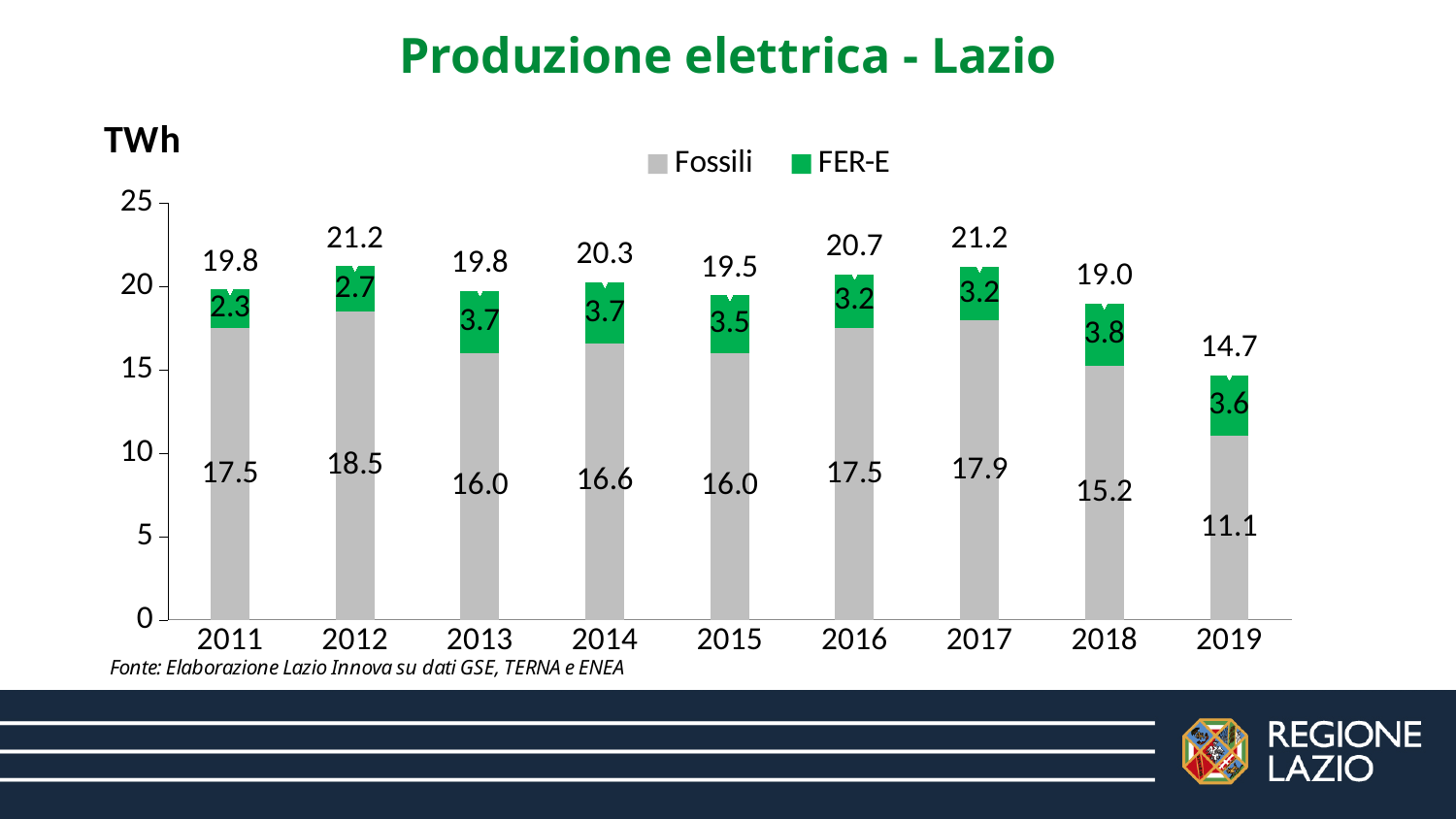
Does the Fossili value rise or fall from 2017 to 2019? Fall What is the FER-E value for 2012? 2.7 Which year has the highest FER-E value? 2018 What kind of chart is shown on the slide? Stacked bar chart What is the total electricity production shown for 2016? 20.7 What is the Fossili value for 2019? 11.1 How many series does the legend list? 2 Which is larger, the FER-E value for 2011 or for 2018? 2018 What is the difference between the Fossili values for 2012 and 2019? 7.4 How many years are shown on the x axis? 9 Which year has the lowest total production? 2019 What unit is indicated for the values on the chart? TWh